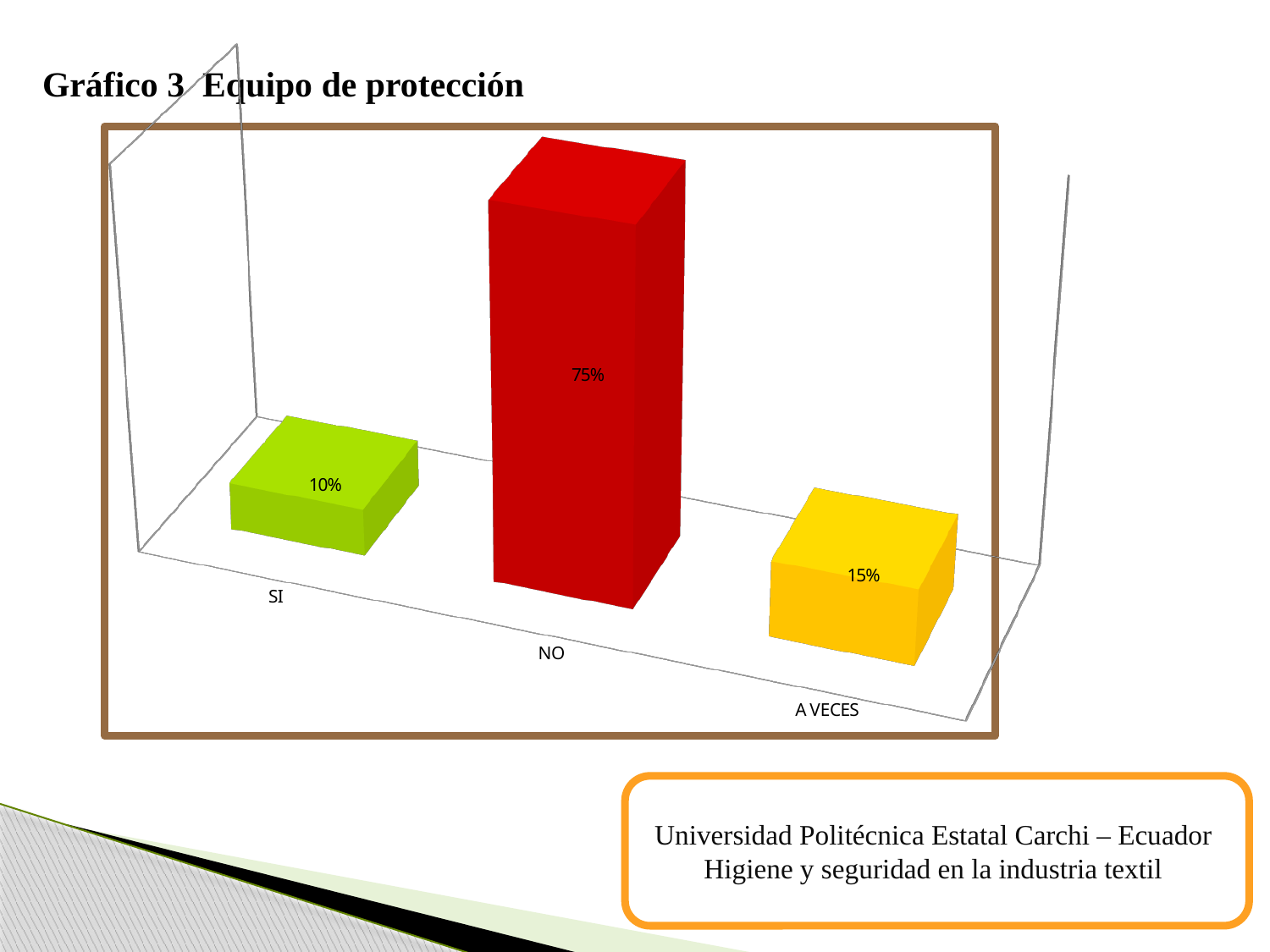
How many categories are shown in the chart? 3 What is the title of the chart? Gráfico 3 Equipo de protección What is the value for NO? 75% Which category has the highest value? NO What is the difference between the values for NO and A VECES? 60% What kind of chart is shown on the slide? Bar chart Which is larger, the value for SI or the value for A VECES? A VECES What is the difference between the values for A VECES and SI? 5% Which category has the lowest value? SI What colour is the bar for NO? Red What is the value for A VECES? 15% What is the value for SI? 10%